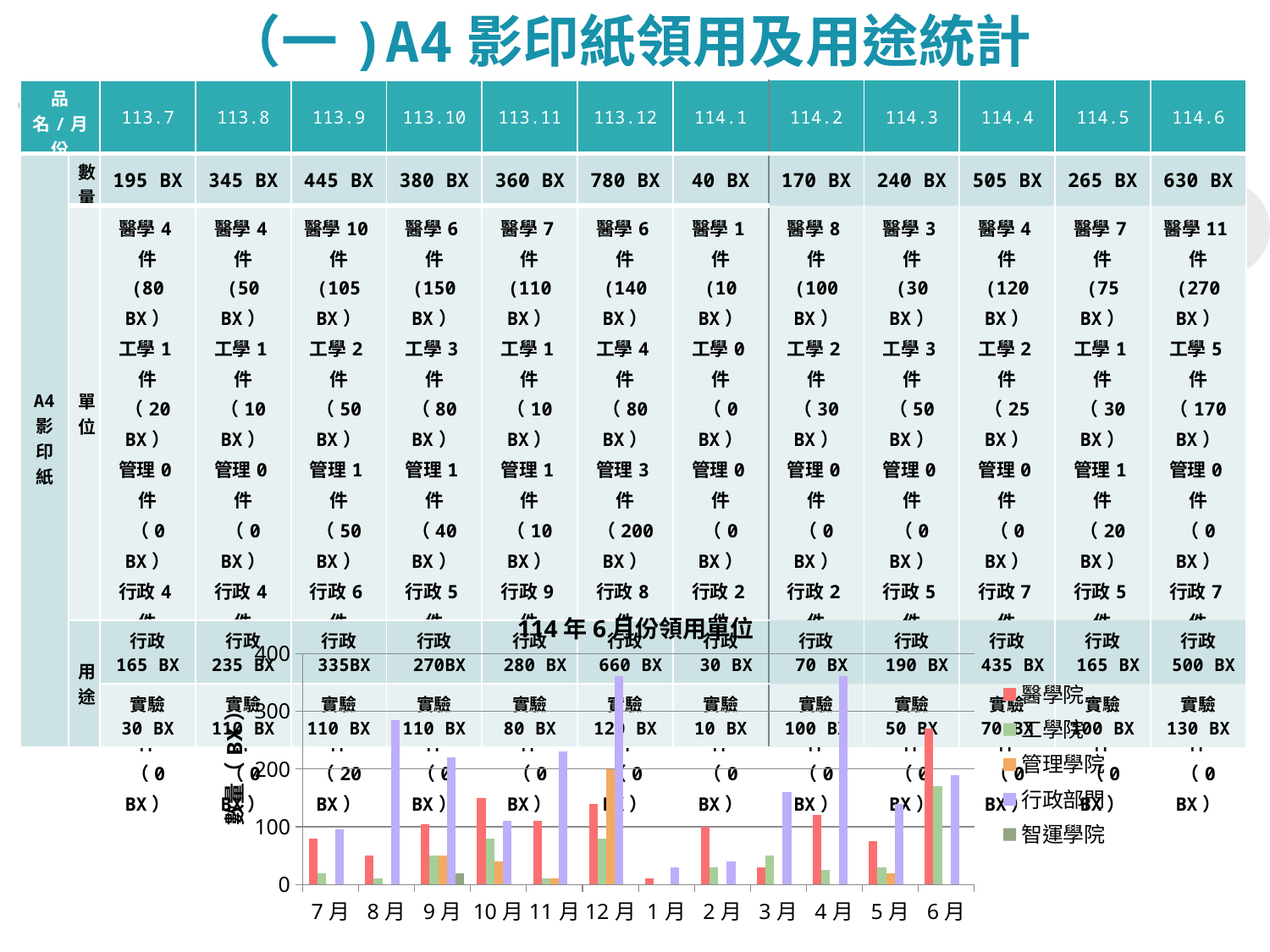
What kind of chart is shown on the slide? bar chart Which series is shown in purple in the chart legend? 行政部門 Is the value for 醫學院 in 1月 greater or less than 100? less Is the value for 行政部門 in 4月 greater or less than 300? greater How many months are shown along the x axis of the chart? 12 What is the title of the chart? 114年6月份領用單位 In which month is the 醫學院 bar the tallest? 6月 How many series does the chart legend list? 5 Is the value for 管理學院 in 12月 greater or less than 100? greater Which is larger, the 工學院 value in 5月 or in 6月? 6月